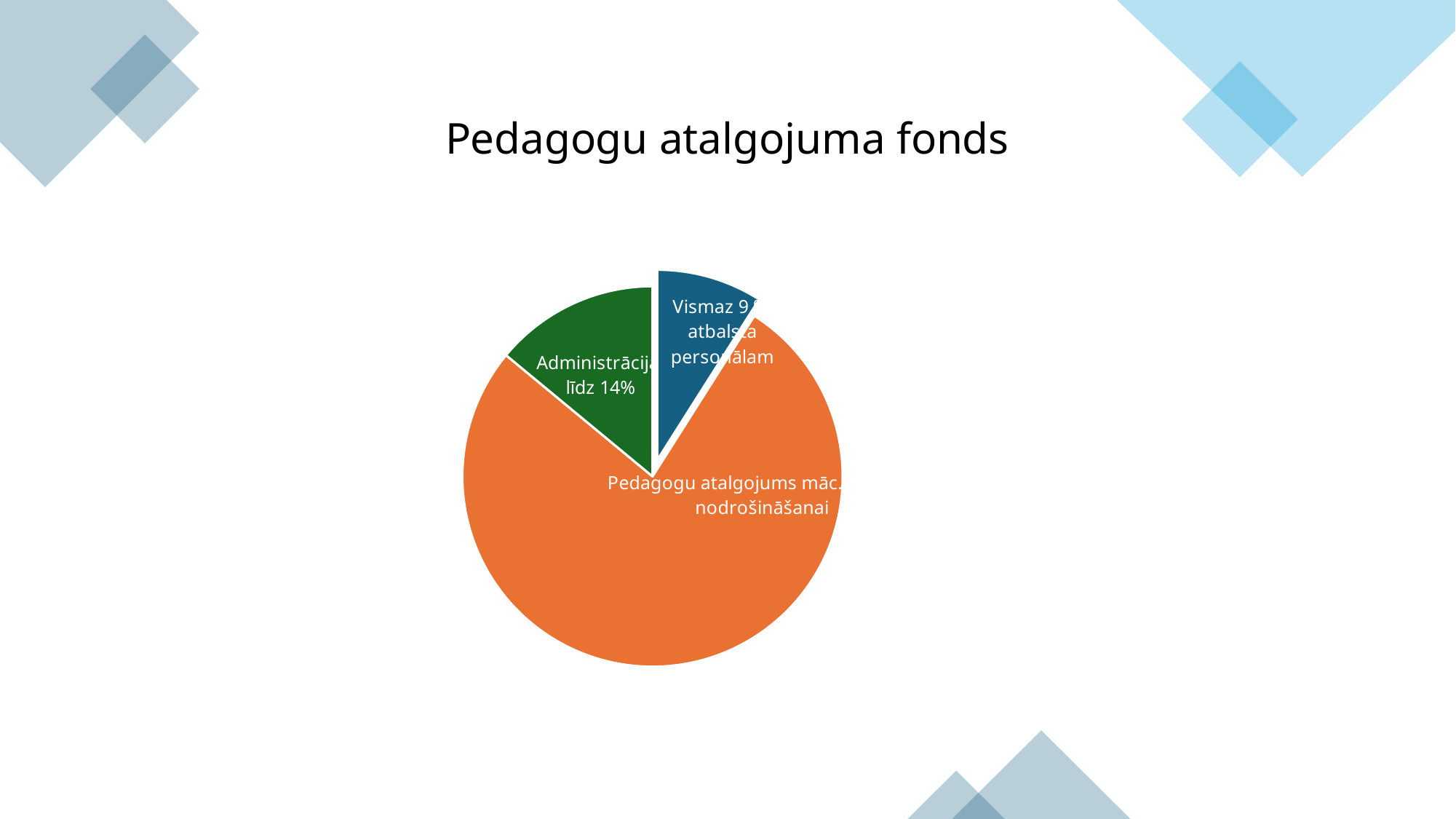
What percentage is shown on the Administrācija slice? līdz 14% Does the Pedagogu atalgojums māc. nodrošināšanai slice represent more or less than half of the pie? more Which slice of the pie chart is the largest? Pedagogu atalgojums māc. nodrošināšanai What colour is the Administrācija slice? Green Which slice is larger: Administrācija or atbalsta personālam? Administrācija Which slice of the pie chart is the smallest? Vismaz 9% atbalsta personālam How many slices does the pie chart have? 3 What is the title of the chart? Pedagogu atalgojuma fonds What kind of chart is shown on the slide? Pie chart